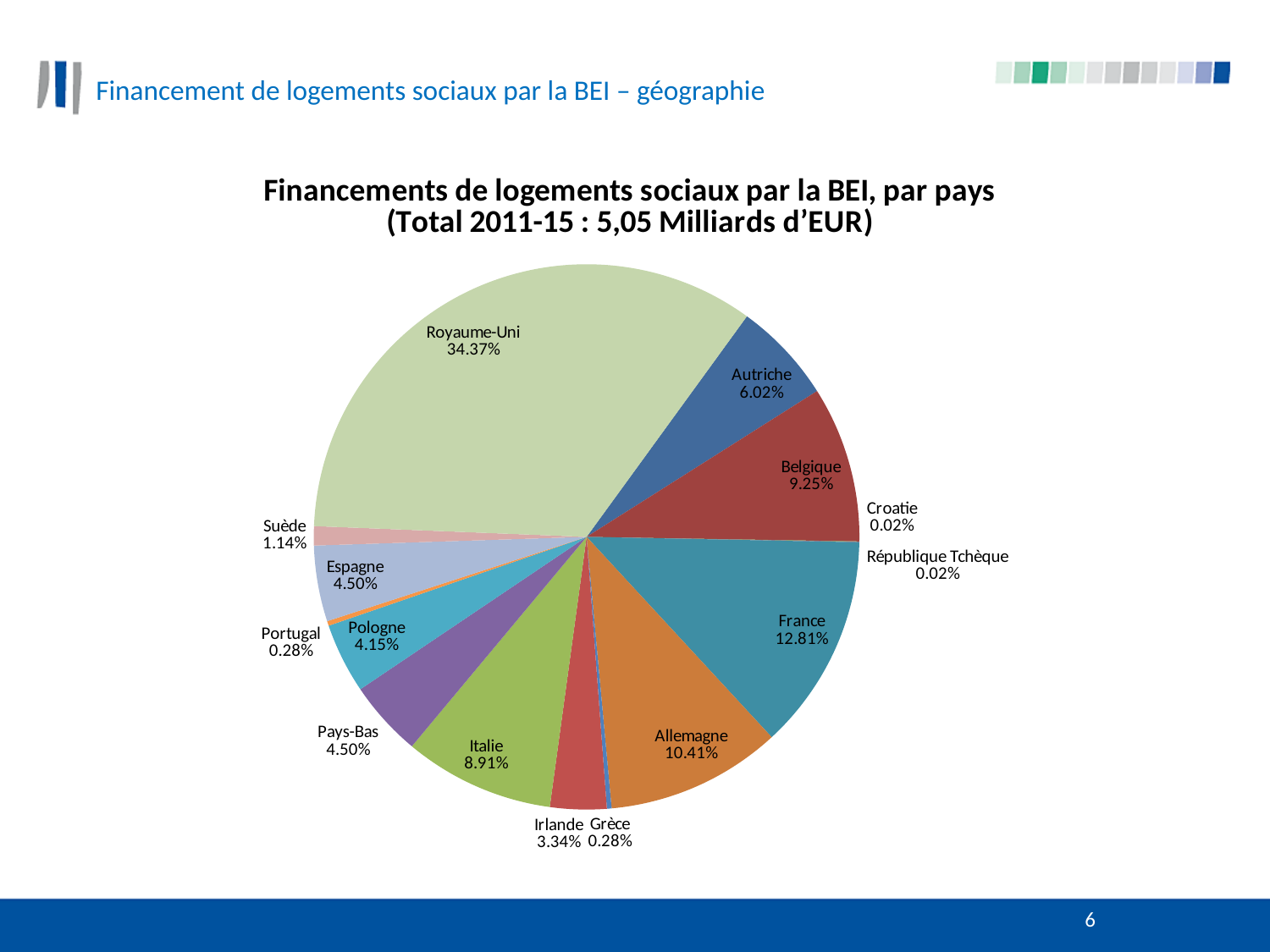
What is the value shown for Allemagne? 10.41% What type of chart is shown on the slide? pie chart What is the difference between the shares of France and Allemagne? 2.40% Which country has the largest slice of the pie? Royaume-Uni What is the value shown for France? 12.81% What is the value shown for Irlande? 3.34% What is the value shown for Suède? 1.14% What share of the pie does Royaume-Uni represent? 34.37% Which has a larger share, Autriche or Pologne? Autriche Which has a larger share, Belgique or Italie? Belgique What total amount for 2011-15 is stated in the chart title? 5,05 Milliards d'EUR How many countries are shown in the pie chart? 15